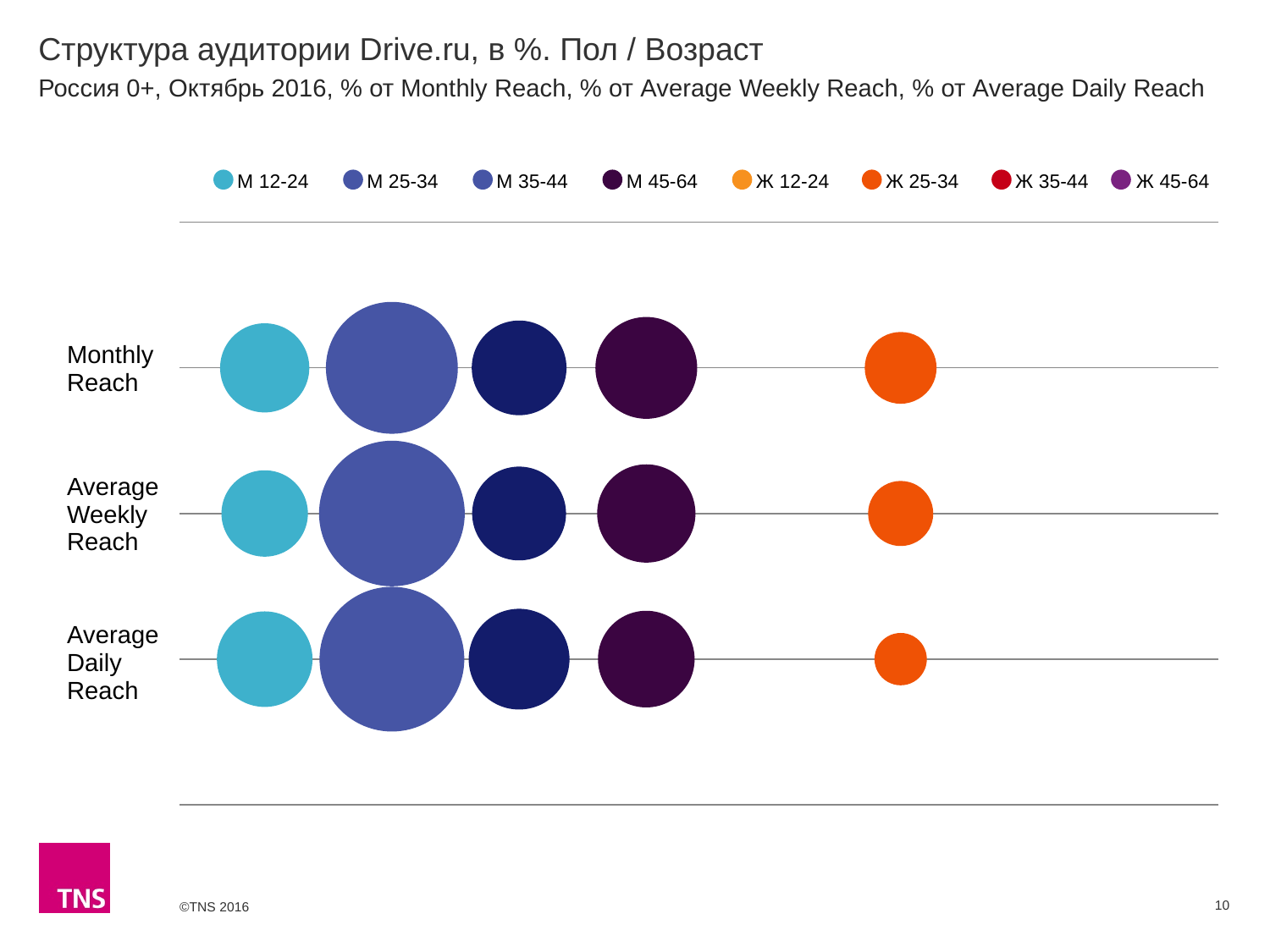
What kind of chart is shown on the slide? Bubble chart Among the visible bubbles in the Average Daily Reach row, which group has the smallest bubble? Ж 25-34 What colour is the bubble for Ж 25-34 in the chart? Orange Which audience group has the largest bubble in the Monthly Reach row? М 25-34 In the Average Daily Reach row, which bubble is larger: М 25-34 or Ж 25-34? М 25-34 How many series does the legend list? 8 In the Monthly Reach row, which bubble is larger: М 45-64 or Ж 25-34? М 45-64 What is the title of the chart on the slide? Структура аудитории Drive.ru, в %. Пол / Возраст What are the three row labels on the chart, from top to bottom? Monthly Reach, Average Weekly Reach, Average Daily Reach How many reach categories (rows) are plotted on the chart? 3 Which audience group has the largest bubble in the Average Daily Reach row? М 25-34